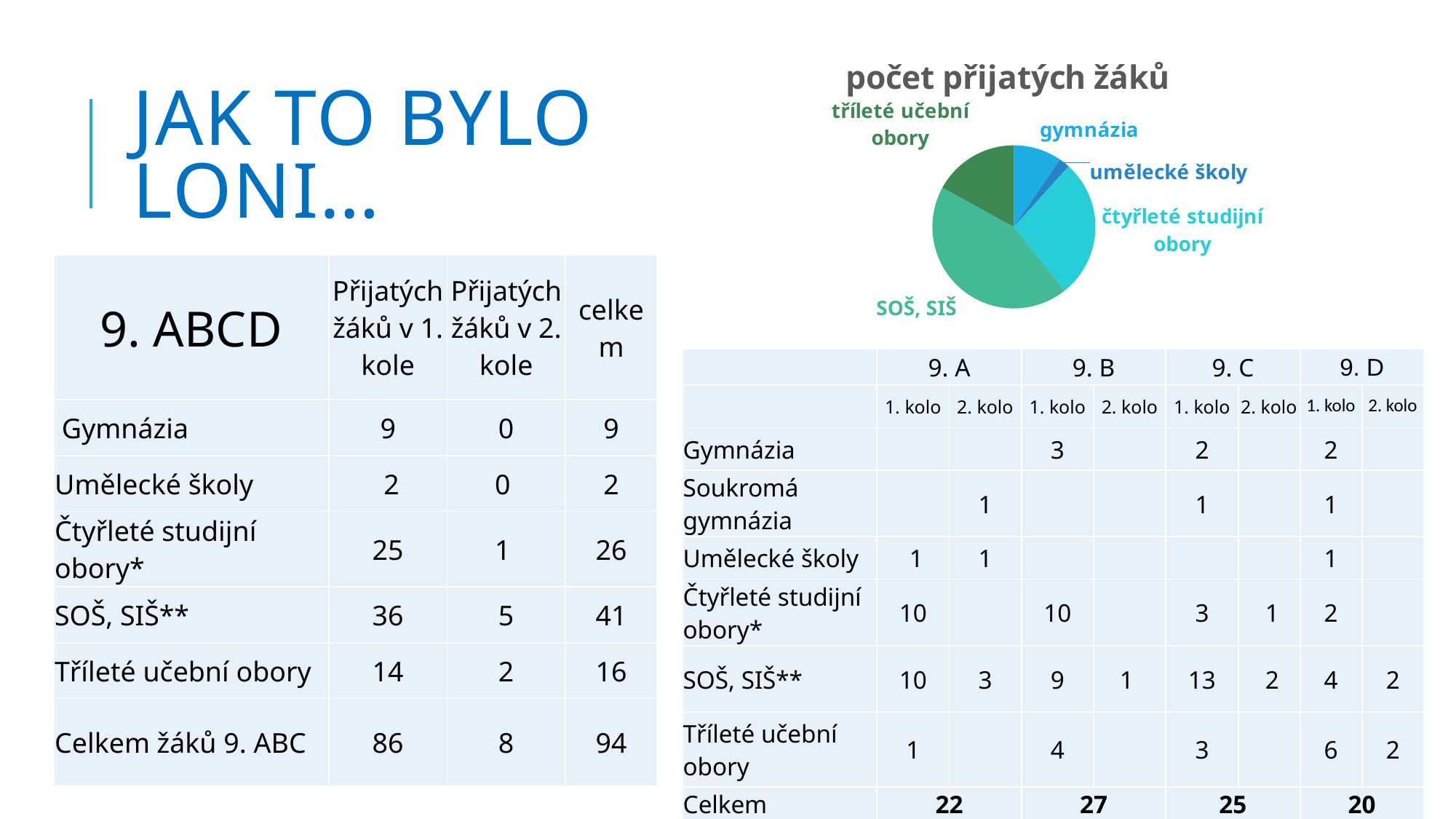
How many slices does the pie chart have? 5 Which category in the pie chart is shown in dark green? tříleté učební obory In the pie chart, which slice is larger: gymnázia or umělecké školy? gymnázia In the pie chart, which slice is larger: SOŠ, SIŠ or gymnázia? SOŠ, SIŠ What is the title of the pie chart? počet přijatých žáků Which category has the largest slice in the pie chart? SOŠ, SIŠ What kind of chart is shown on the slide? pie chart In the pie chart, which slice is larger: čtyřleté studijní obory or tříleté učební obory? čtyřleté studijní obory Which category has the smallest slice in the pie chart? umělecké školy